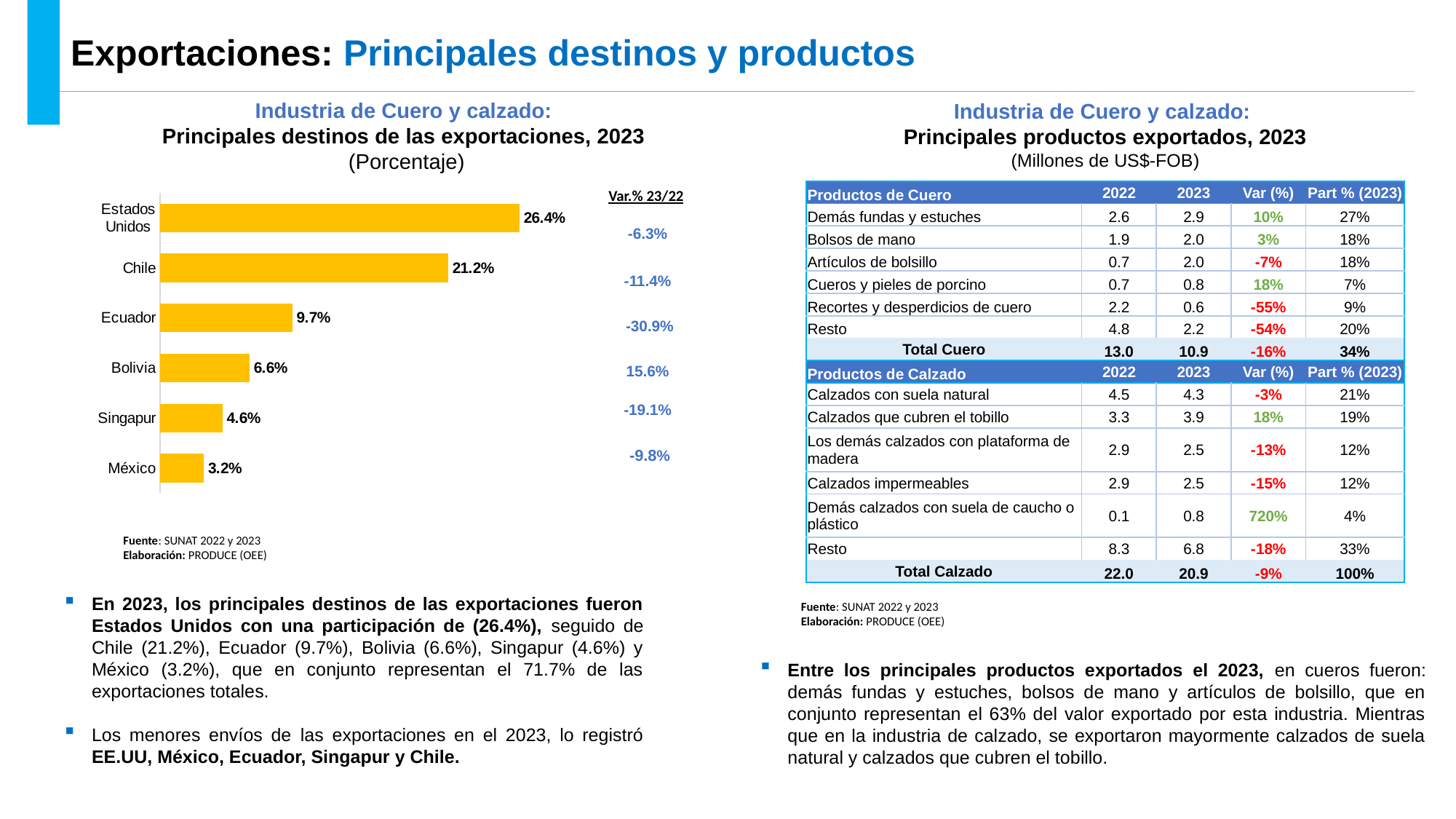
Which destination has the highest export share in the bar chart? Estados Unidos What type of chart is used to show the main export destinations in 2023? Bar chart Which destination has the lowest export share in the bar chart? México What is the Var.% 23/22 value shown next to the bar for Bolivia? 15.6% Which has a larger export share, Ecuador or Bolivia? Ecuador How many destinations are shown in the bar chart? 6 Do the bar values rise or fall from the top bar (Estados Unidos) to the bottom bar (México)? Fall What is the difference between the export shares of Bolivia and México? 3.4% What is the export share for Singapur in the bar chart? 4.6% What is the export share for Ecuador in the bar chart? 9.7% What is the difference between the export shares of Estados Unidos and Chile? 5.2% What is the export share for Estados Unidos in the bar chart? 26.4%